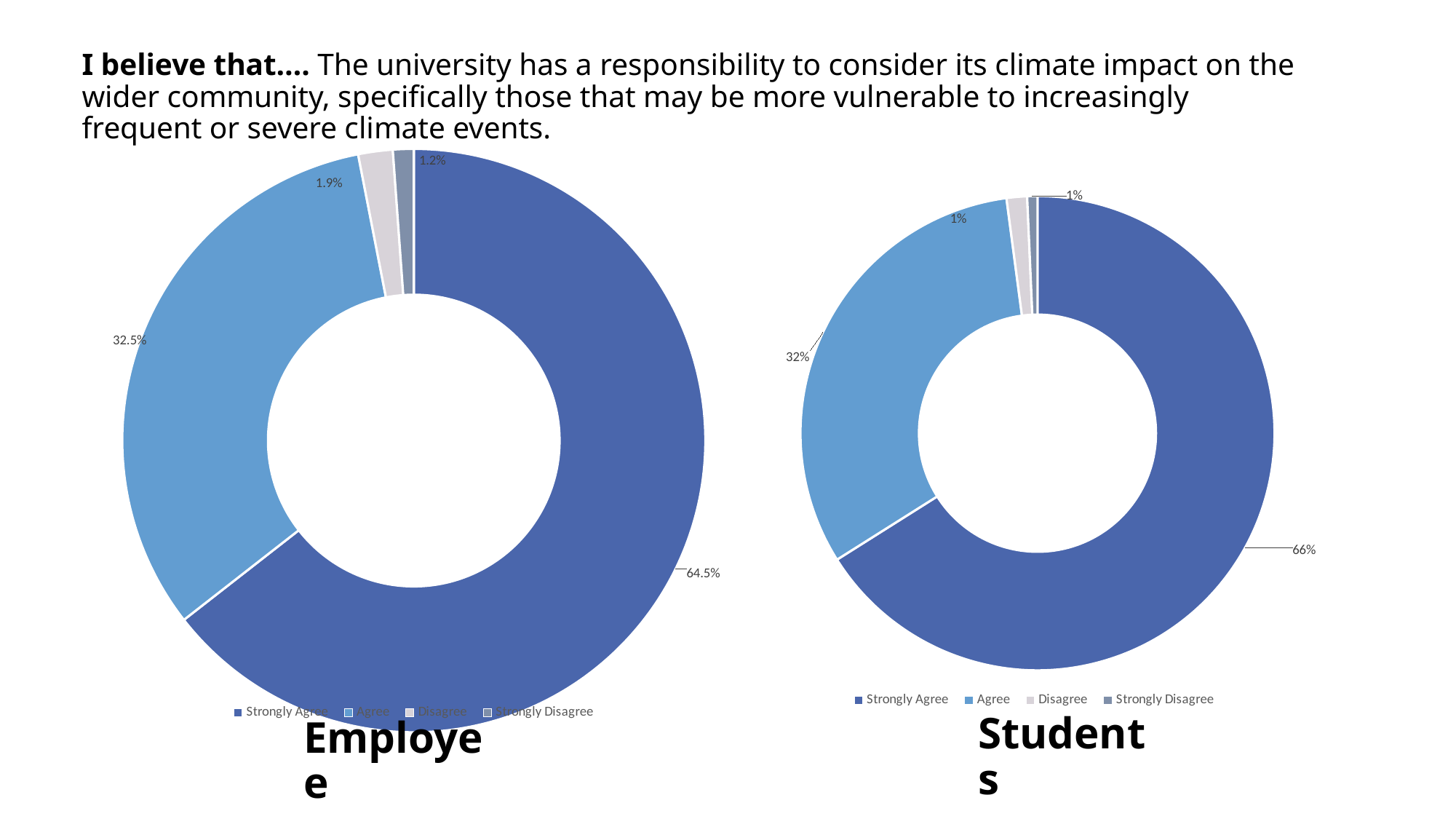
In the Employee chart, which response category has the largest share? Strongly Agree In the Students chart, what percentage of respondents selected Agree? 32% In the Employee chart, what is the difference between the Strongly Agree and Agree shares? 32 percentage points In the Employee chart, what percentage of respondents selected Agree? 32.5% In the Employee chart, what percentage of respondents selected Disagree? 1.9% How many entries does the legend of the Employee chart list? 4 How many response categories are shown in the Students chart? 4 Which chart shows a larger Strongly Agree share, Employee or Students? Students What type of chart is used for the Students data? Doughnut chart In the Students chart, what percentage of respondents selected Strongly Agree? 66% In the Employee chart, which response category has the smallest share? Strongly Disagree In the Employee chart, what percentage of respondents selected Strongly Agree? 64.5%